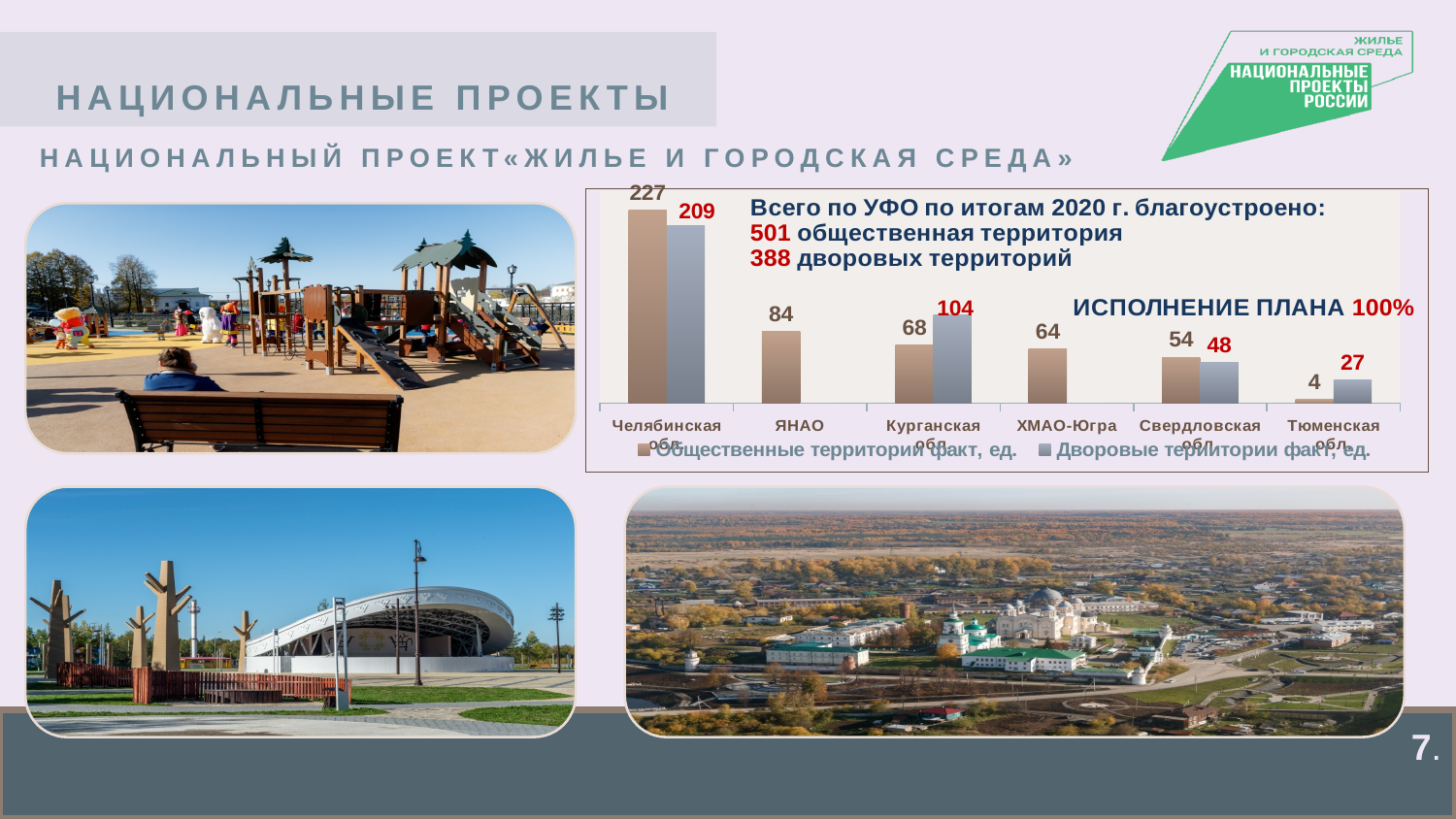
What is the difference between the 'Общественные территории' and 'Дворовые территории' values for Челябинская обл.? 18 What is the value of 'Дворовые территории факт, ед.' for Тюменская обл.? 27 Which region has the highest value for 'Общественные территории факт, ед.'? Челябинская обл. What is the value of 'Общественные территории факт, ед.' for Челябинская обл.? 227 How many series does the chart legend list? 2 What is the value of 'Дворовые территории факт, ед.' for Курганская обл.? 104 According to the text in the chart, how many public territories (общественная территория) were improved in total across УФО in 2020? 501 What is the value of 'Общественные территории факт, ед.' for ЯНАО? 84 What type of chart is shown on the slide? bar chart How many regions (categories) are shown on the x axis of the chart? 6 Which region has the lowest value for 'Общественные территории факт, ед.'? Тюменская обл. For Свердловская обл., which is larger: 'Общественные территории факт, ед.' or 'Дворовые территории факт, ед.'? Общественные территории факт, ед.